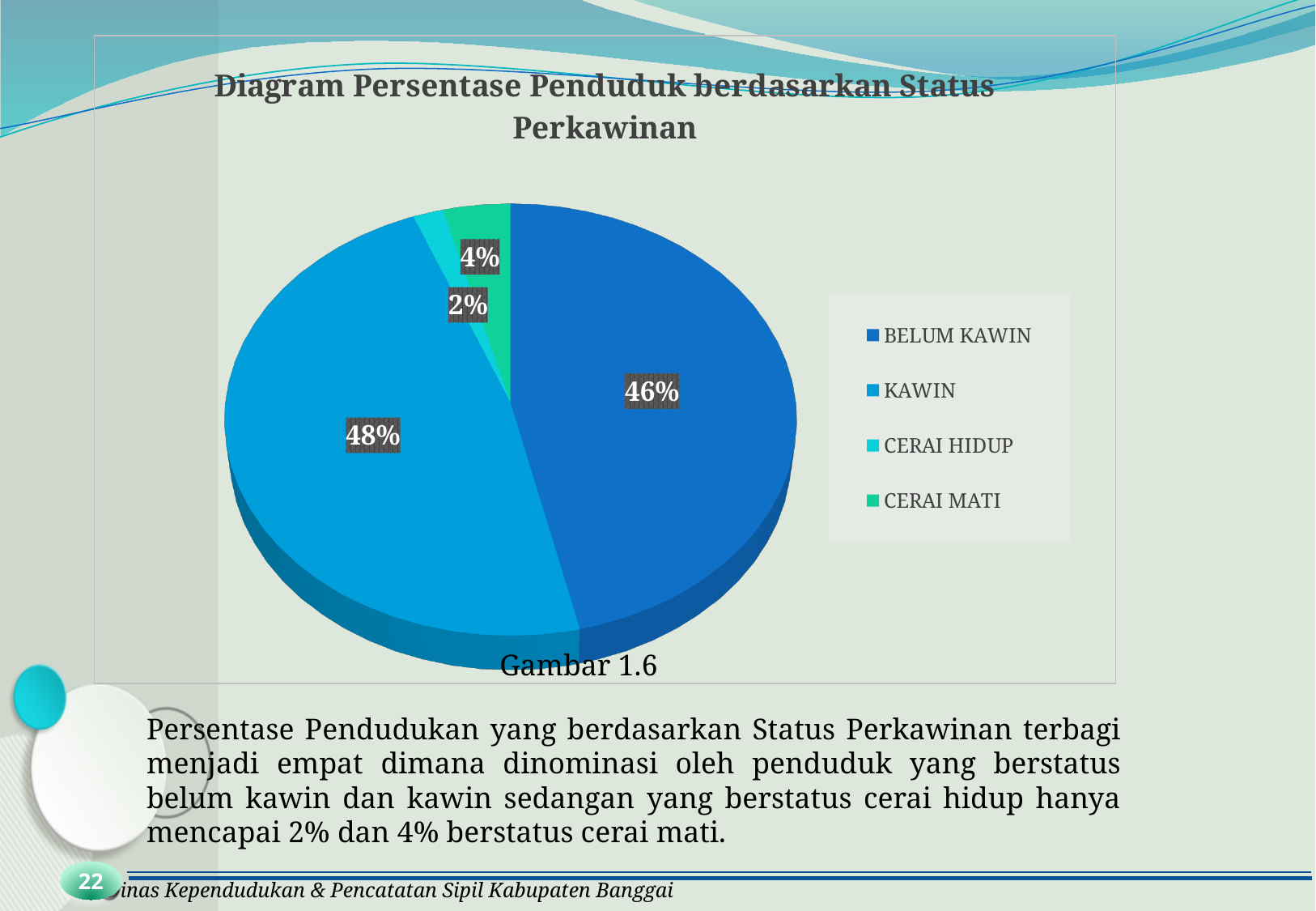
What is the difference in percentage points between KAWIN and BELUM KAWIN? 2 What percentage of the population has the status CERAI MATI? 4% What figure number is given in the caption below the chart? Gambar 1.6 Which is larger, the share for CERAI MATI or the share for CERAI HIDUP? CERAI MATI What is the title of the chart? Diagram Persentase Penduduk berdasarkan Status Perkawinan Which marital status has the largest share of the pie? KAWIN What percentage of the population has the status BELUM KAWIN? 46% How many categories does the pie chart show? 4 Which marital status has the smallest share of the pie? CERAI HIDUP What percentage of the population has the status KAWIN? 48% What type of chart is shown on the slide? Pie chart What percentage of the population has the status CERAI HIDUP? 2%